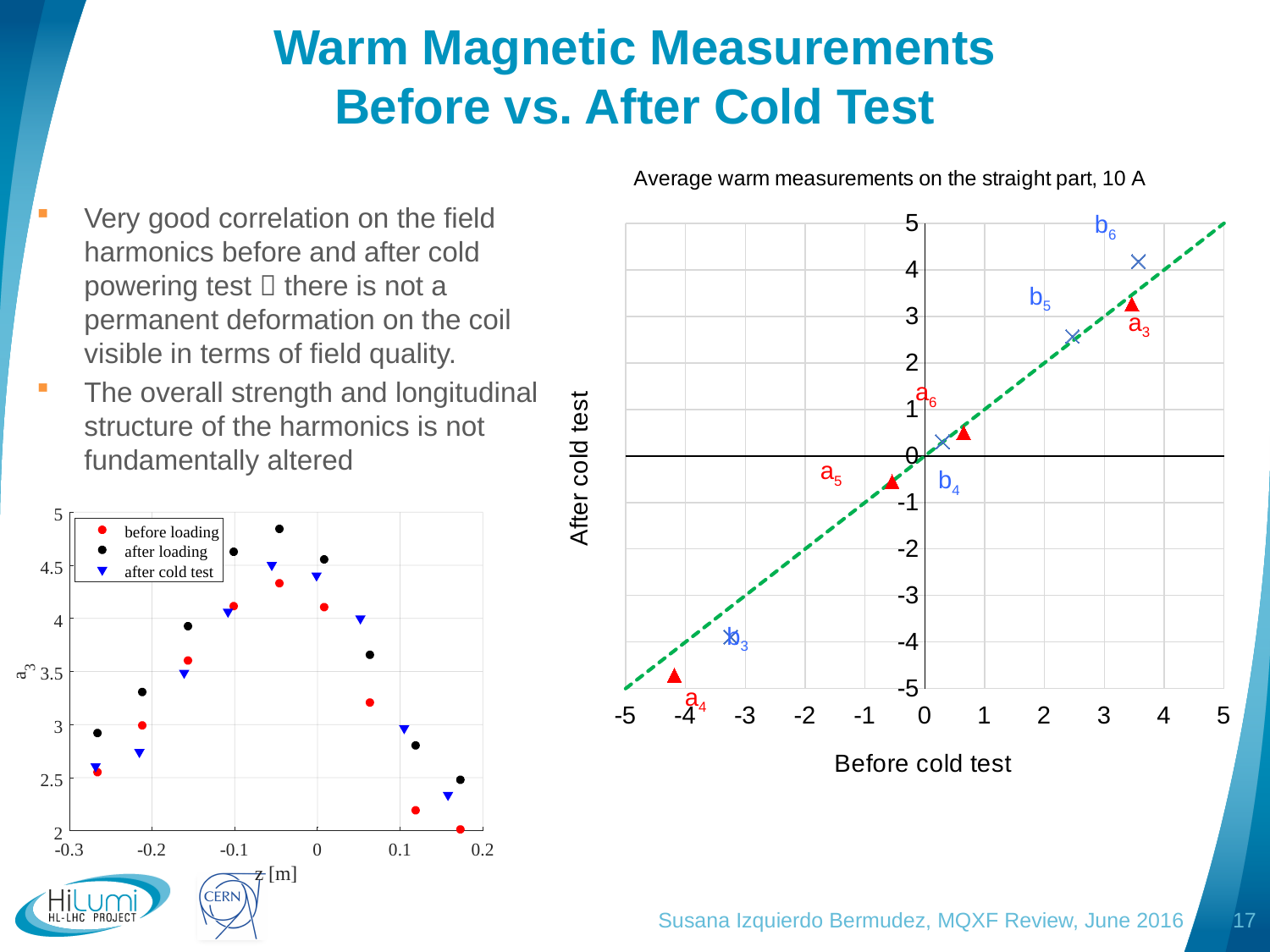
In the chart titled 'Average warm measurements on the straight part, 10 A', do the plotted points rise or fall as the 'Before cold test' value increases? rise What kind of chart is the left chart with a3 on the y axis? scatter chart In the chart titled 'Average warm measurements on the straight part, 10 A', is the 'Before cold test' value for a4 greater or less than -4? less In the left chart, is the highest 'after loading' value greater or less than 4.5? greater In the left chart, at the leftmost z position (about -0.27 m), which is larger: the 'before loading' value or the 'after loading' value? after loading How many series does the legend of the left chart list? 3 What is the x-axis label of the left chart? z [m] In the chart titled 'Average warm measurements on the straight part, 10 A', which labelled harmonic has the highest 'After cold test' value? b6 In the chart titled 'Average warm measurements on the straight part, 10 A', is the 'After cold test' value for b6 greater or less than 4? greater In the left chart, which series reaches the highest a3 value? after loading In the chart titled 'Average warm measurements on the straight part, 10 A', which labelled harmonic has the lowest 'Before cold test' value? a4